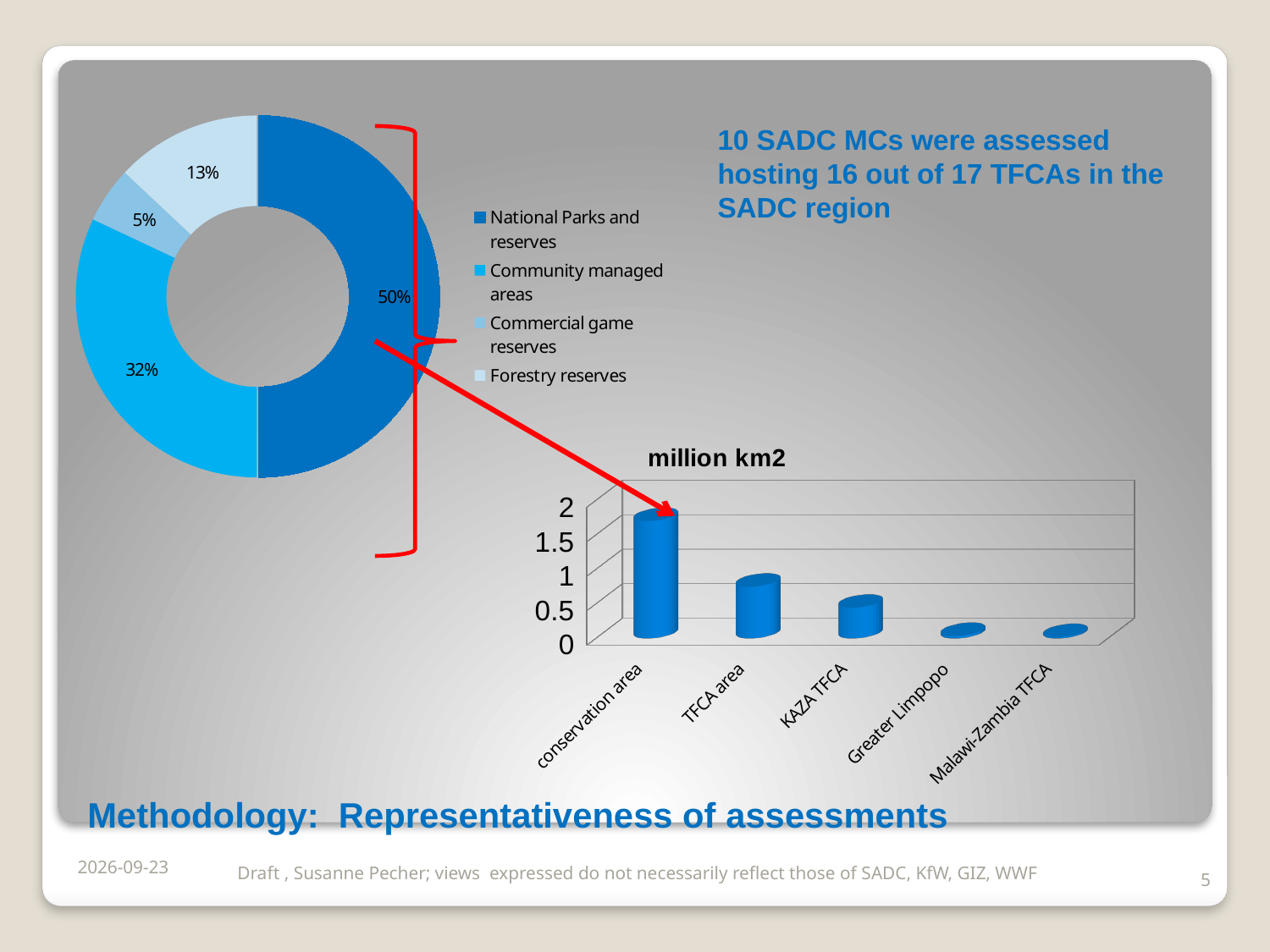
In the 'million km2' chart, is the value for TFCA area greater or less than 1? less In the 'million km2' chart, how many categories are shown on the x axis? 5 In the doughnut chart on the left, what is the difference in percentage points between National Parks and reserves and Community managed areas? 18 In the doughnut chart on the left, which category has the smallest share? Commercial game reserves In the 'million km2' chart, is the value for conservation area greater or less than 1.5? greater In the doughnut chart on the left, what share is shown for Community managed areas? 32% In the 'million km2' chart, do the bar values rise or fall from left to right along the x axis? fall In the doughnut chart on the left, which category has the largest share? National Parks and reserves In the 'million km2' chart, which category has the tallest bar? conservation area In the doughnut chart on the left, how many categories does the legend list? 4 In the doughnut chart on the left, what share is shown for National Parks and reserves? 50% In the doughnut chart on the left, what share is shown for Forestry reserves? 13%